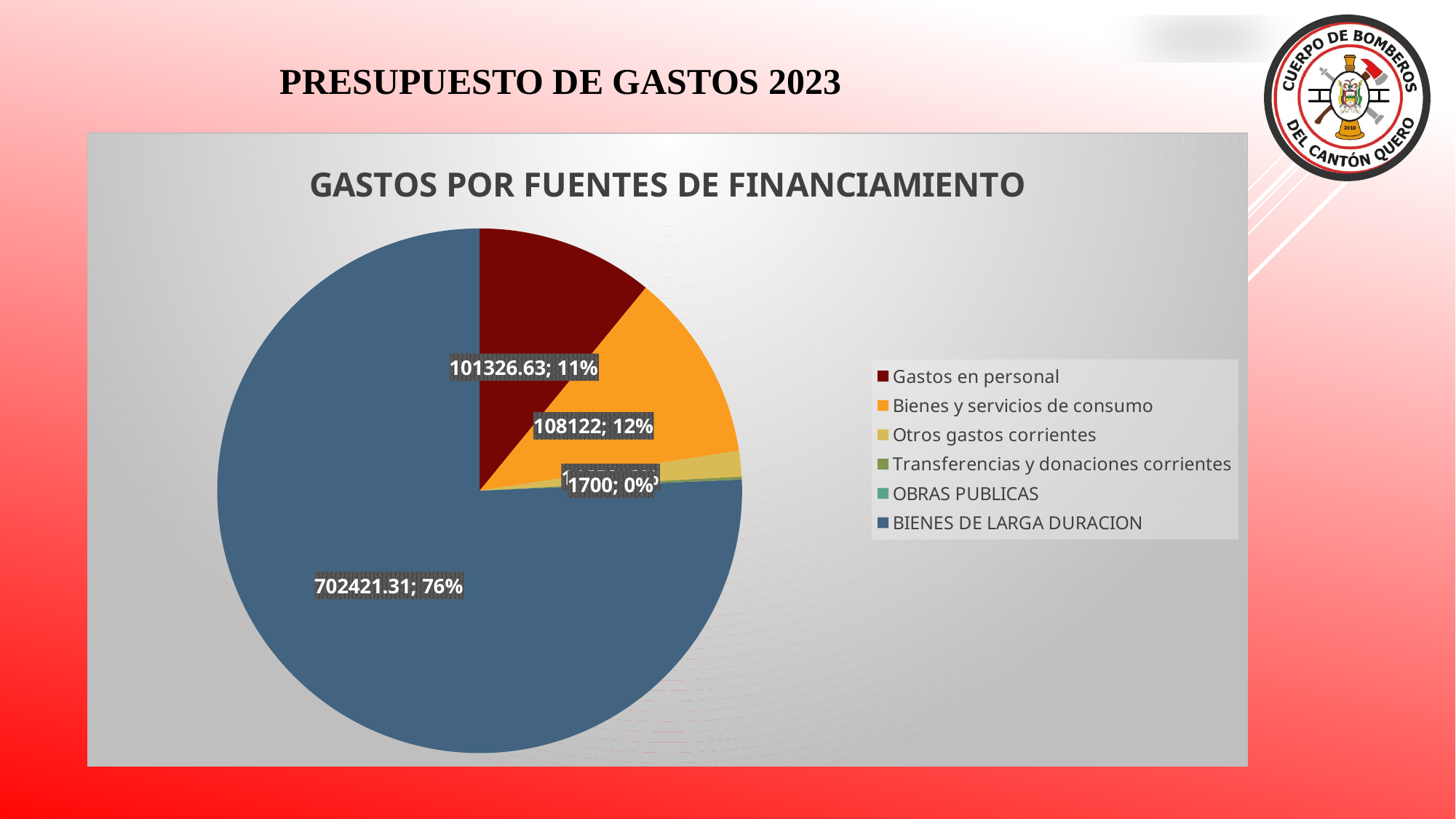
How many categories does the legend of the pie chart list? 6 What is the value shown for BIENES DE LARGA DURACION? 702421.31 What is the value shown for Gastos en personal? 101326.63 What is the title of the chart? GASTOS POR FUENTES DE FINANCIAMIENTO Which category has the largest slice of the pie? BIENES DE LARGA DURACION What is the difference between the values for Bienes y servicios de consumo and Gastos en personal? 6795.37 What share of the pie does Bienes y servicios de consumo represent? 12% What kind of chart is shown on the slide? pie chart What is the value shown for Bienes y servicios de consumo? 108122 Which is larger, Gastos en personal or Bienes y servicios de consumo? Bienes y servicios de consumo What share of the pie does BIENES DE LARGA DURACION represent? 76% What share of the pie does Gastos en personal represent? 11%